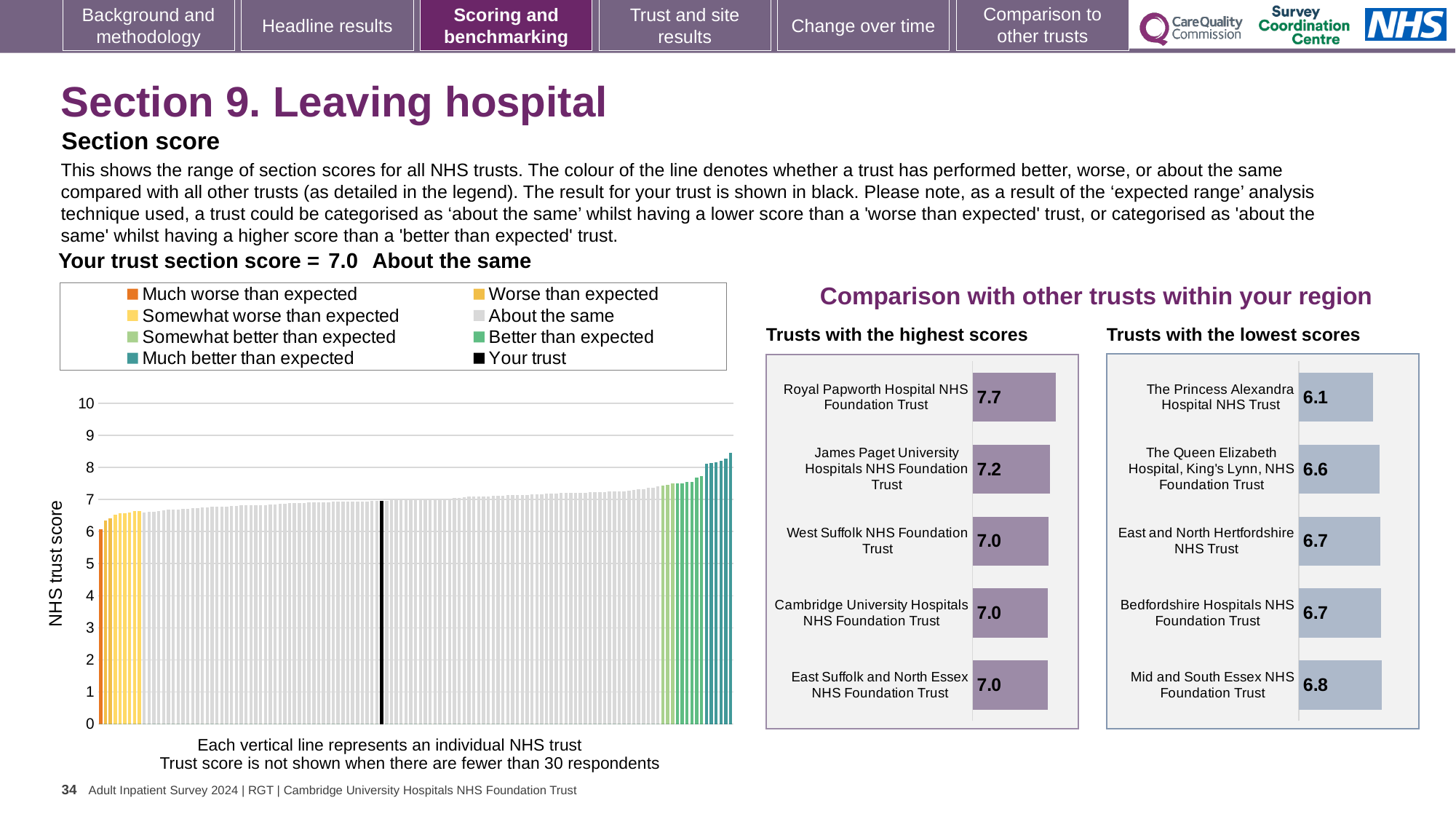
In the 'Trusts with the lowest scores' chart, what is the score for The Princess Alexandra Hospital NHS Trust? 6.1 In the main NHS trust score chart on the left, what is the section score for your trust (the black bar)? 7.0 In the 'Trusts with the lowest scores' chart, which has the larger score: The Queen Elizabeth Hospital, King's Lynn, NHS Foundation Trust or Mid and South Essex NHS Foundation Trust? Mid and South Essex NHS Foundation Trust In the 'Trusts with the highest scores' chart, what is the score for James Paget University Hospitals NHS Foundation Trust? 7.2 How many entries does the legend of the main NHS trust score chart on the left list? 8 In the 'Trusts with the highest scores' chart, what is the score for Royal Papworth Hospital NHS Foundation Trust? 7.7 How many trusts are listed in the 'Trusts with the lowest scores' chart? 5 In the 'Trusts with the lowest scores' chart, which trust has the lowest score? The Princess Alexandra Hospital NHS Trust In the main NHS trust score chart on the left, do the trust scores rise or fall from left to right along the x axis? rise In the 'Trusts with the lowest scores' chart, what is the score for Mid and South Essex NHS Foundation Trust? 6.8 In the 'Trusts with the highest scores' chart, which trust has the highest score? Royal Papworth Hospital NHS Foundation Trust In the 'Trusts with the highest scores' chart, what is the difference between the scores of Royal Papworth Hospital NHS Foundation Trust and James Paget University Hospitals NHS Foundation Trust? 0.5